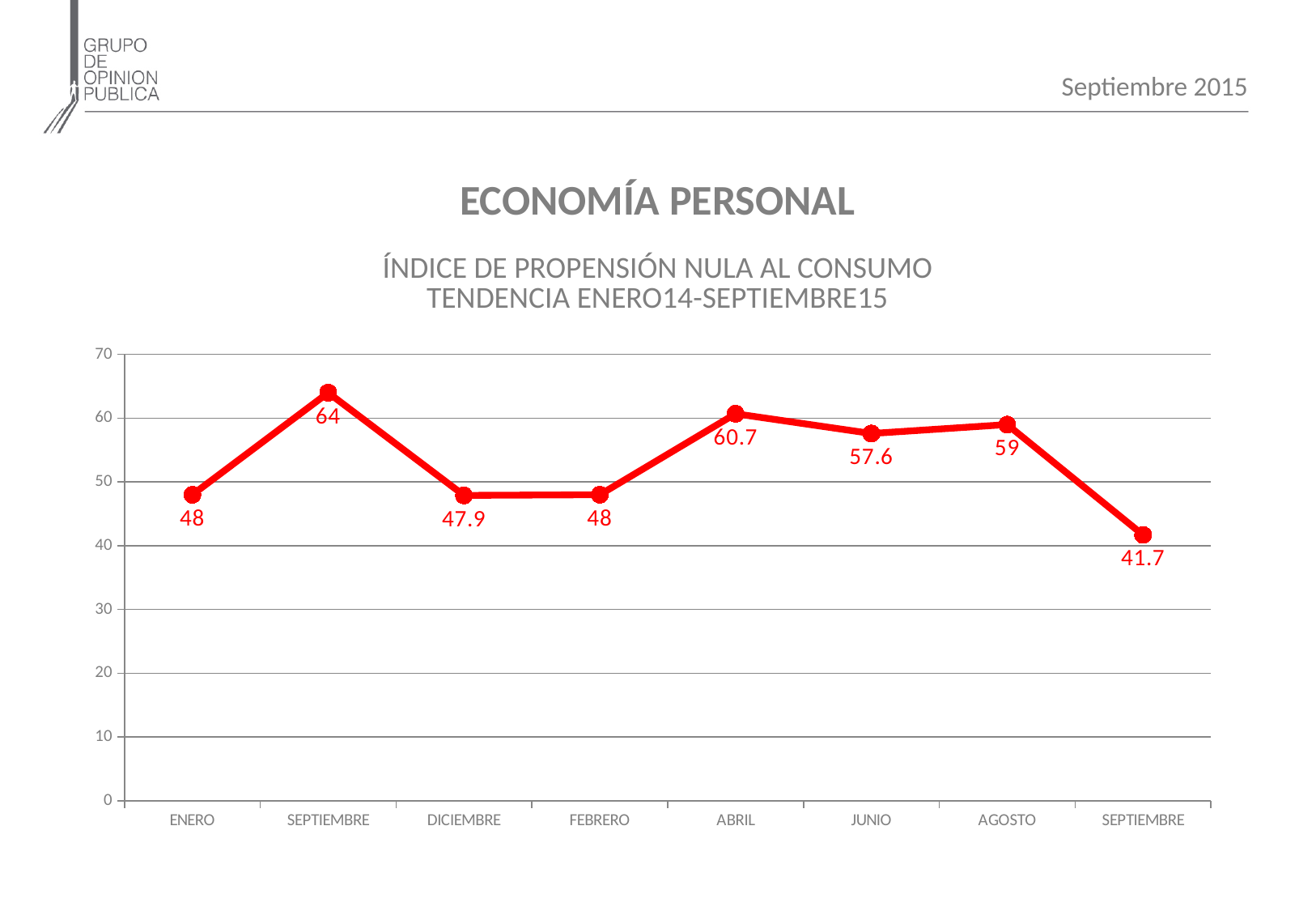
Do the values rise or fall from AGOSTO to the final SEPTIEMBRE point? Fall Which category has the highest value? SEPTIEMBRE (the second point, 64) What is the value for the last point on the x axis, SEPTIEMBRE (rightmost)? 41.7 What is the difference between the values for ABRIL and JUNIO? 3.1 How many data points are plotted on the line? 8 What is the difference between the highest value (64) and the lowest value (41.7)? 22.3 What is the value for JUNIO? 57.6 Which category has the lowest value? SEPTIEMBRE (the last point, 41.7) What is the value for ENERO? 48 Which is larger, the value for ABRIL or the value for AGOSTO? ABRIL What kind of chart is shown on the slide? Line chart What is the value for ABRIL? 60.7